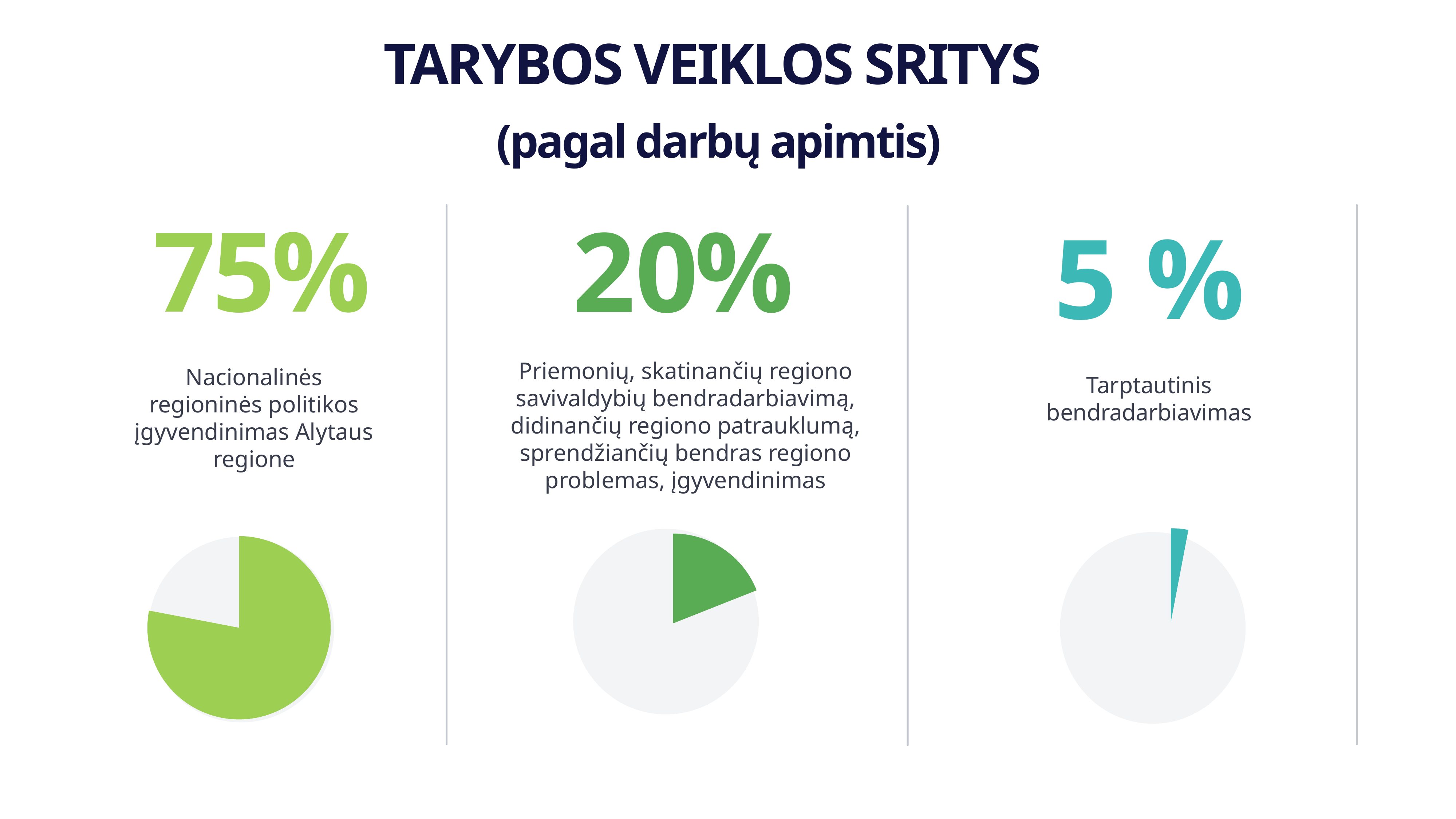
What is the main title of the slide? TARYBOS VEIKLOS SRITYS What kind of charts are shown on the slide? Pie charts Which activity area has the smallest share of work volume? Tarptautinis bendradarbiavimas How many pie charts are on the slide? 3 What is the difference in percentage points between the middle pie chart (20%) and the right pie chart (5 %)? 15 Which activity area has the largest share of work volume? Nacionalinės regioninės politikos įgyvendinimas Alytaus regione Which is larger: the share for the middle pie chart or the share for the right pie chart ('Tarptautinis bendradarbiavimas')? The middle pie chart (20%) What percentage is shown for the left pie chart, 'Nacionalinės regioninės politikos įgyvendinimas Alytaus regione'? 75% What colour is the filled slice in the right pie chart ('Tarptautinis bendradarbiavimas')? Teal What percentage is shown for the right pie chart, 'Tarptautinis bendradarbiavimas'? 5 % What percentage is shown for the middle pie chart about measures promoting cooperation between the region's municipalities? 20% What is the difference in percentage points between the left pie chart (75%) and the middle pie chart (20%)? 55